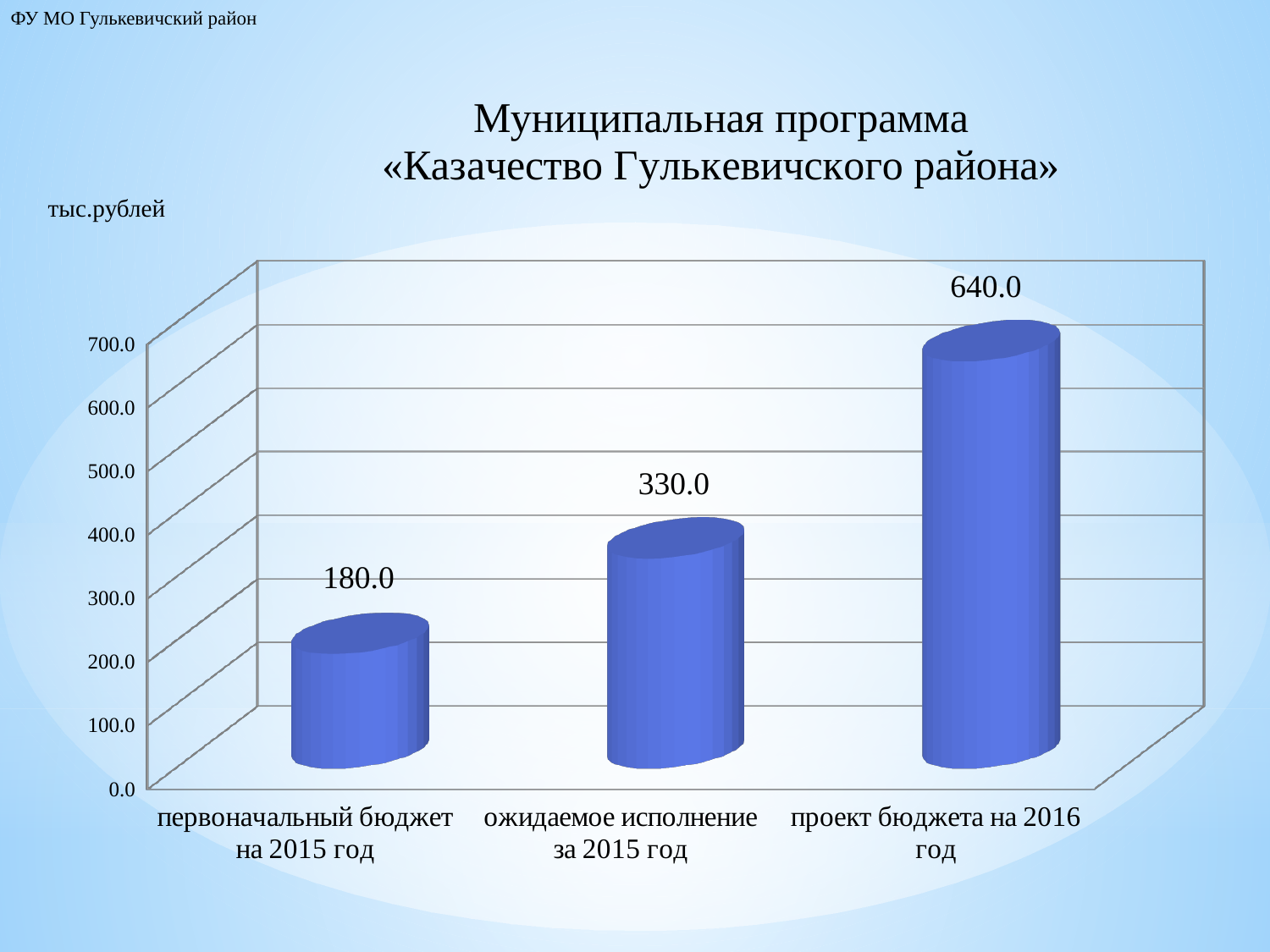
How many categories are shown in the chart? 3 Which category has the lowest value? первоначальный бюджет на 2015 год What kind of chart is shown on the slide? bar chart Do the values rise or fall from left to right along the x axis? rise Is the value for «проект бюджета на 2016 год» greater or less than 500.0? greater Which is larger: the value for «ожидаемое исполнение за 2015 год» or the value for «первоначальный бюджет на 2015 год»? ожидаемое исполнение за 2015 год What is the value for «ожидаемое исполнение за 2015 год»? 330.0 What is the value for «первоначальный бюджет на 2015 год»? 180.0 What is the difference between the value for «ожидаемое исполнение за 2015 год» and the value for «первоначальный бюджет на 2015 год»? 150.0 Which category has the highest value? проект бюджета на 2016 год What is the difference between the value for «проект бюджета на 2016 год» and the value for «ожидаемое исполнение за 2015 год»? 310.0 What is the value for «проект бюджета на 2016 год»? 640.0